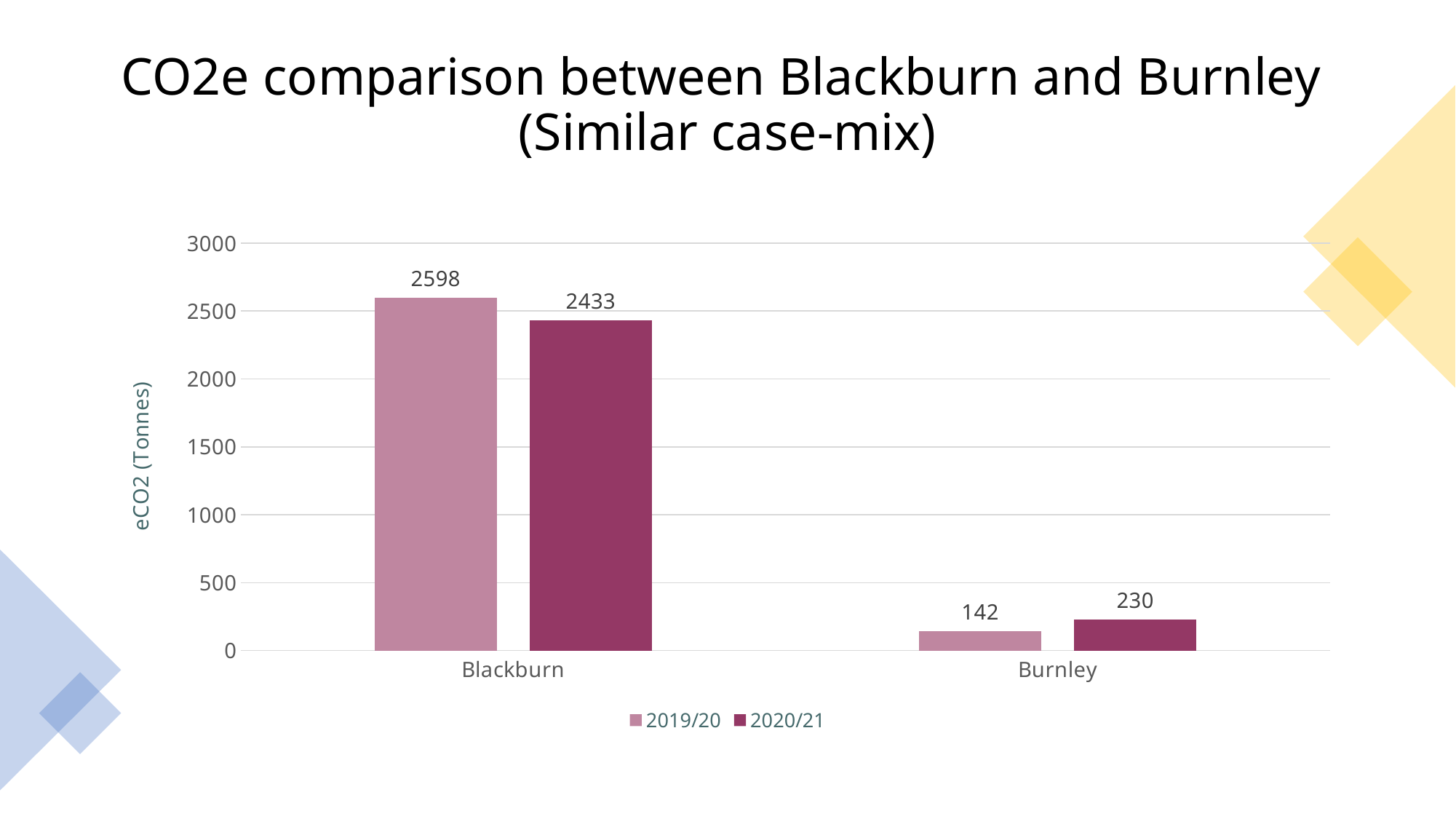
What is the eCO2 value for Burnley in 2019/20? 142 What is the eCO2 value for Burnley in 2020/21? 230 Which is larger: Burnley in 2019/20 or Burnley in 2020/21? Burnley in 2020/21 Which bar has the highest value on the chart? Blackburn 2019/20 What is the eCO2 value for Blackburn in 2019/20? 2598 What is the difference between Burnley's 2020/21 and 2019/20 values? 88 What is the label on the vertical axis? eCO2 (Tonnes) How many series does the legend list? 2 Which bar has the lowest value on the chart? Burnley 2019/20 What kind of chart is shown on the slide? Bar chart What is the difference between Blackburn's 2019/20 and 2020/21 values? 165 What is the eCO2 value for Blackburn in 2020/21? 2433